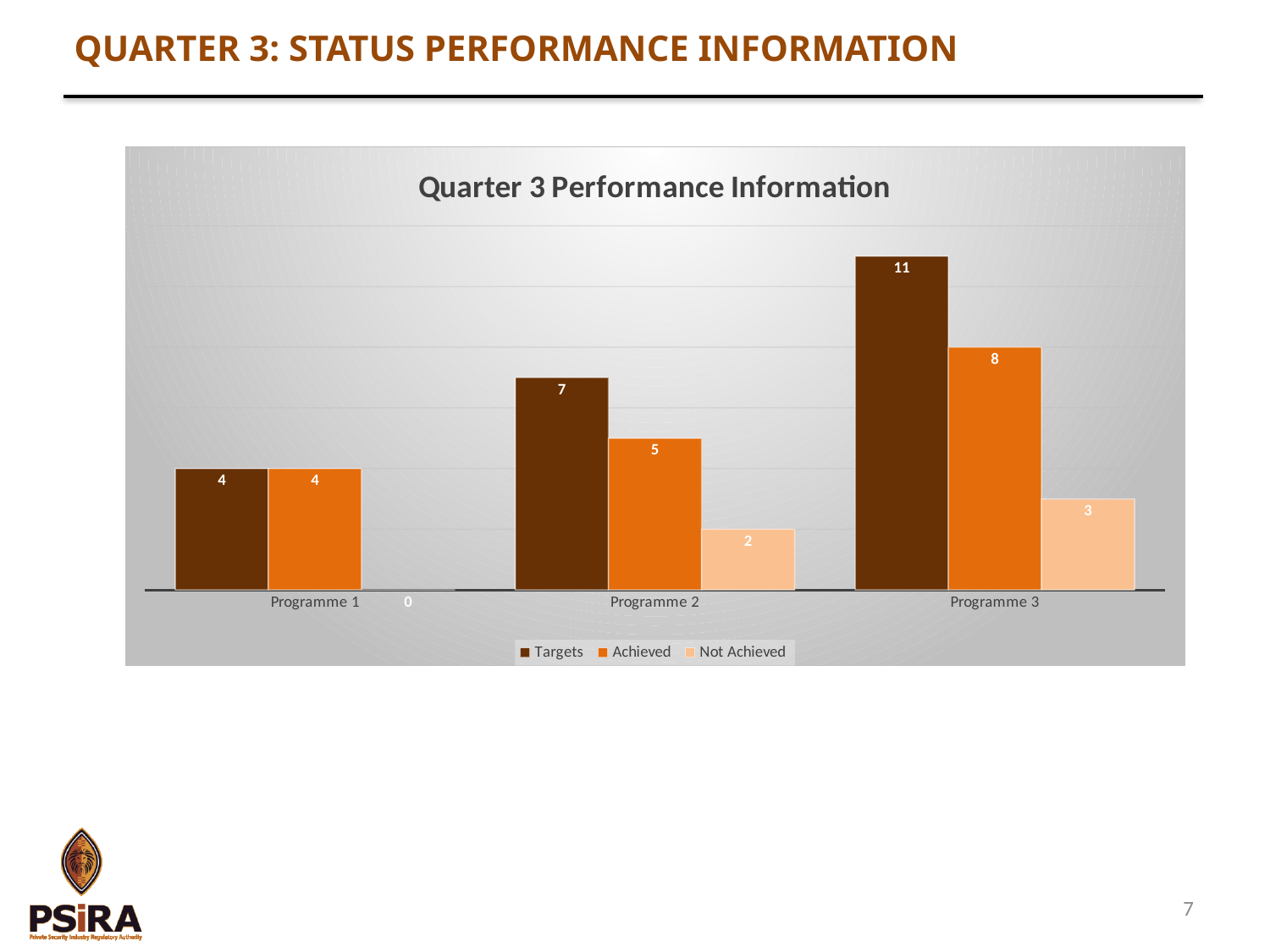
Which is larger for Programme 2: Targets or Achieved? Targets Which programme has the highest Targets value? Programme 3 What is the difference between Targets and Achieved for Programme 3? 3 Do the Targets values rise or fall from Programme 1 to Programme 3? Rise How many series does the legend list? 3 How many programmes are shown on the x axis? 3 What is the Achieved value for Programme 2? 5 What is the Not Achieved value for Programme 1? 0 What is the Targets value for Programme 3? 11 Which programme has the lowest Achieved value? Programme 1 What kind of chart is shown on the slide? Bar chart What is the title of the chart? Quarter 3 Performance Information